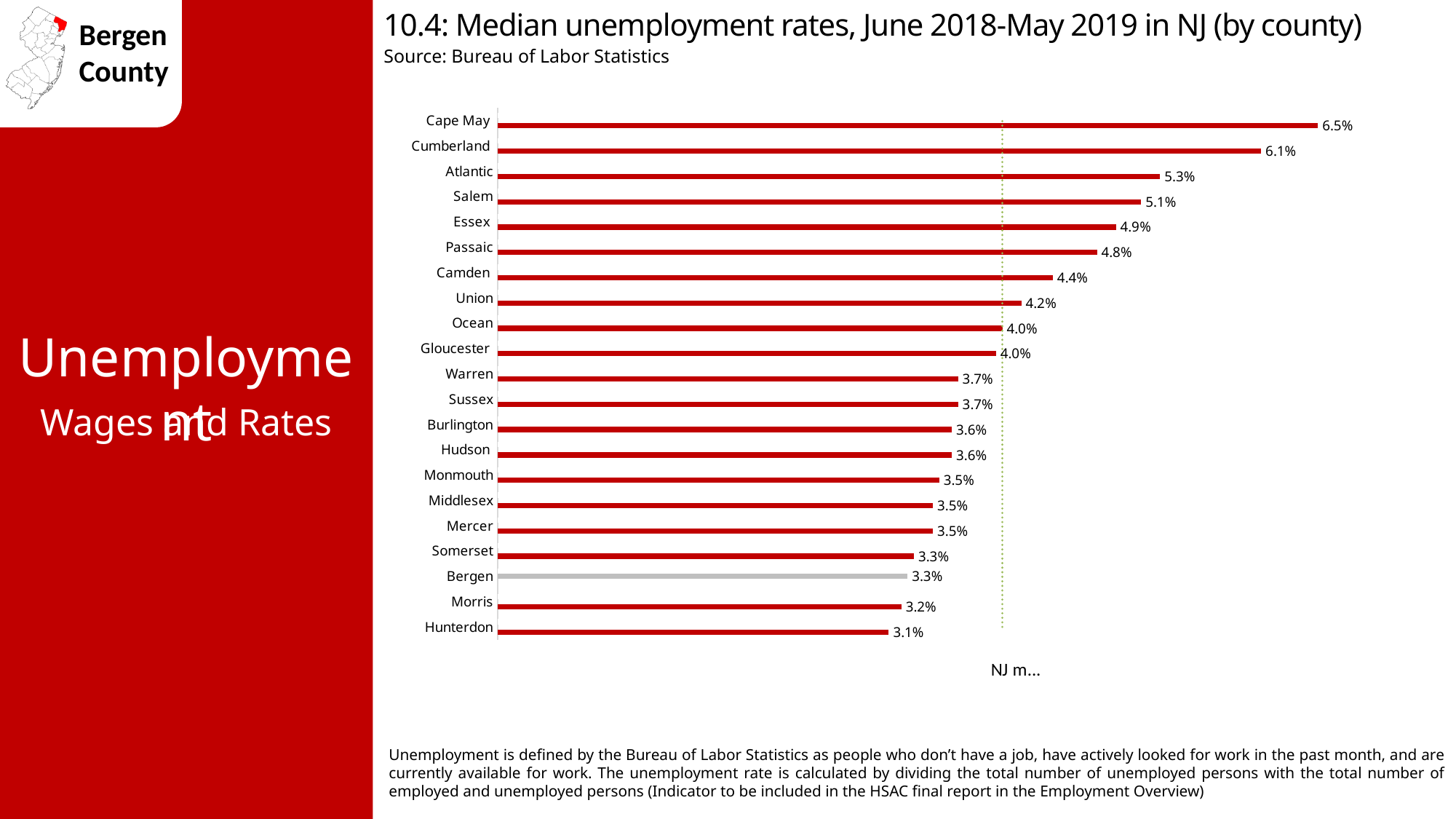
What kind of chart is shown on the slide? Bar chart What is the source cited for the chart? Bureau of Labor Statistics What is the difference between the median unemployment rates of Cumberland and Morris? 2.9% What is the median unemployment rate for Cape May? 6.5% Which county has a higher median unemployment rate, Essex or Camden? Essex What is the difference between the median unemployment rates of Atlantic and Salem? 0.2% How many counties are shown in the chart? 21 What is the median unemployment rate for Bergen? 3.3% Which county has the highest median unemployment rate? Cape May Which county has the lowest median unemployment rate? Hunterdon Which county's bar is coloured grey instead of red? Bergen What is the median unemployment rate for Passaic? 4.8%